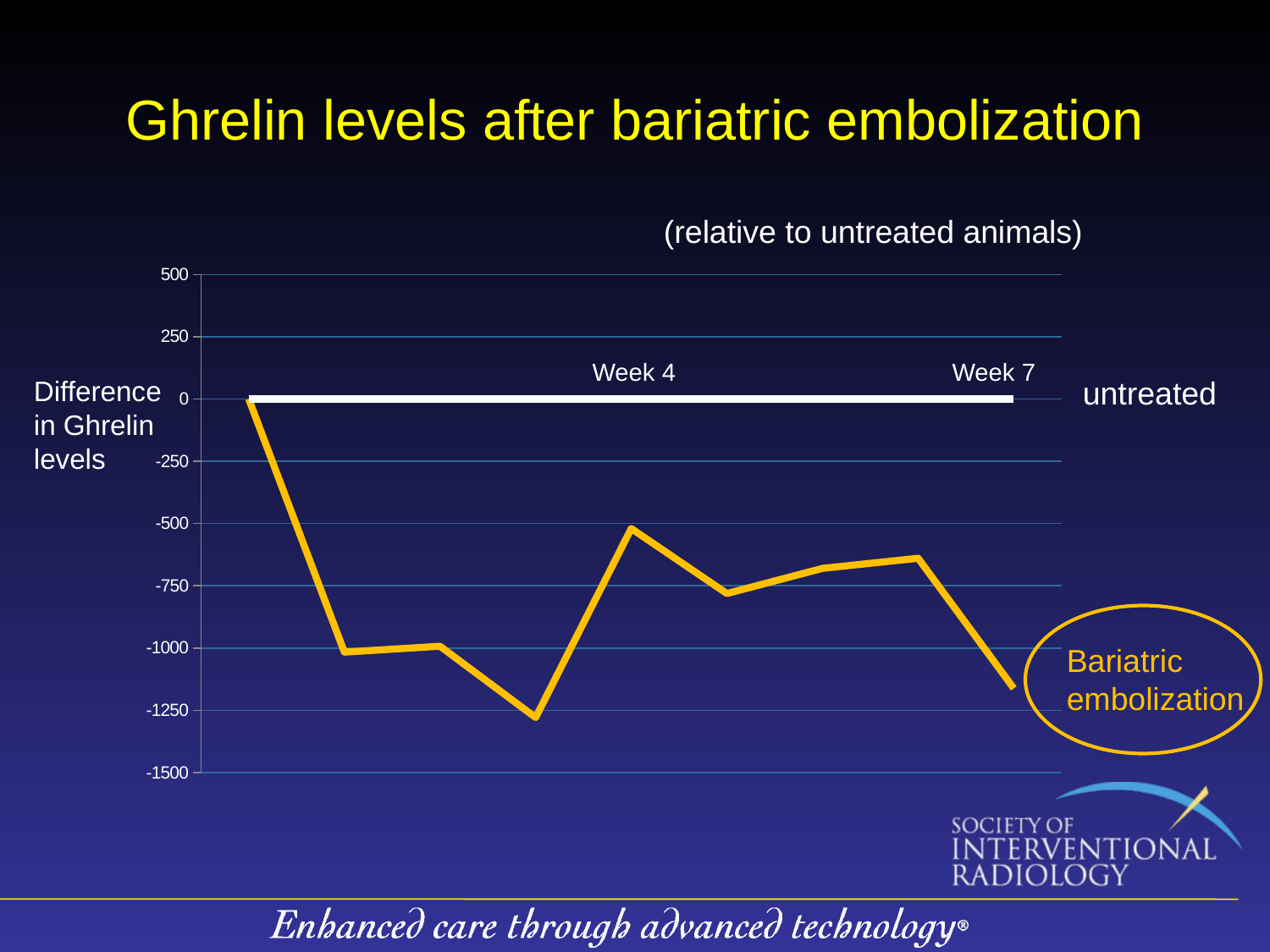
How many data series are plotted on the chart? 2 What is the title of the chart on the slide? Ghrelin levels after bariatric embolization Is the lowest point of the Bariatric embolization line greater or less than -1000? less Is the lowest point of the Bariatric embolization line greater or less than -1500? greater Which series has the higher values across the chart, untreated or Bariatric embolization? untreated What type of chart is shown on the slide? line chart What value does the untreated line sit at throughout the chart? 0 How many week labels are shown along the x axis of the chart? 2 Overall, does the Bariatric embolization line rise or fall from its starting point to Week 7? fall Is the value of the Bariatric embolization line at Week 7 greater or less than -1000? less What is the label on the vertical axis of the chart? Difference in Ghrelin levels